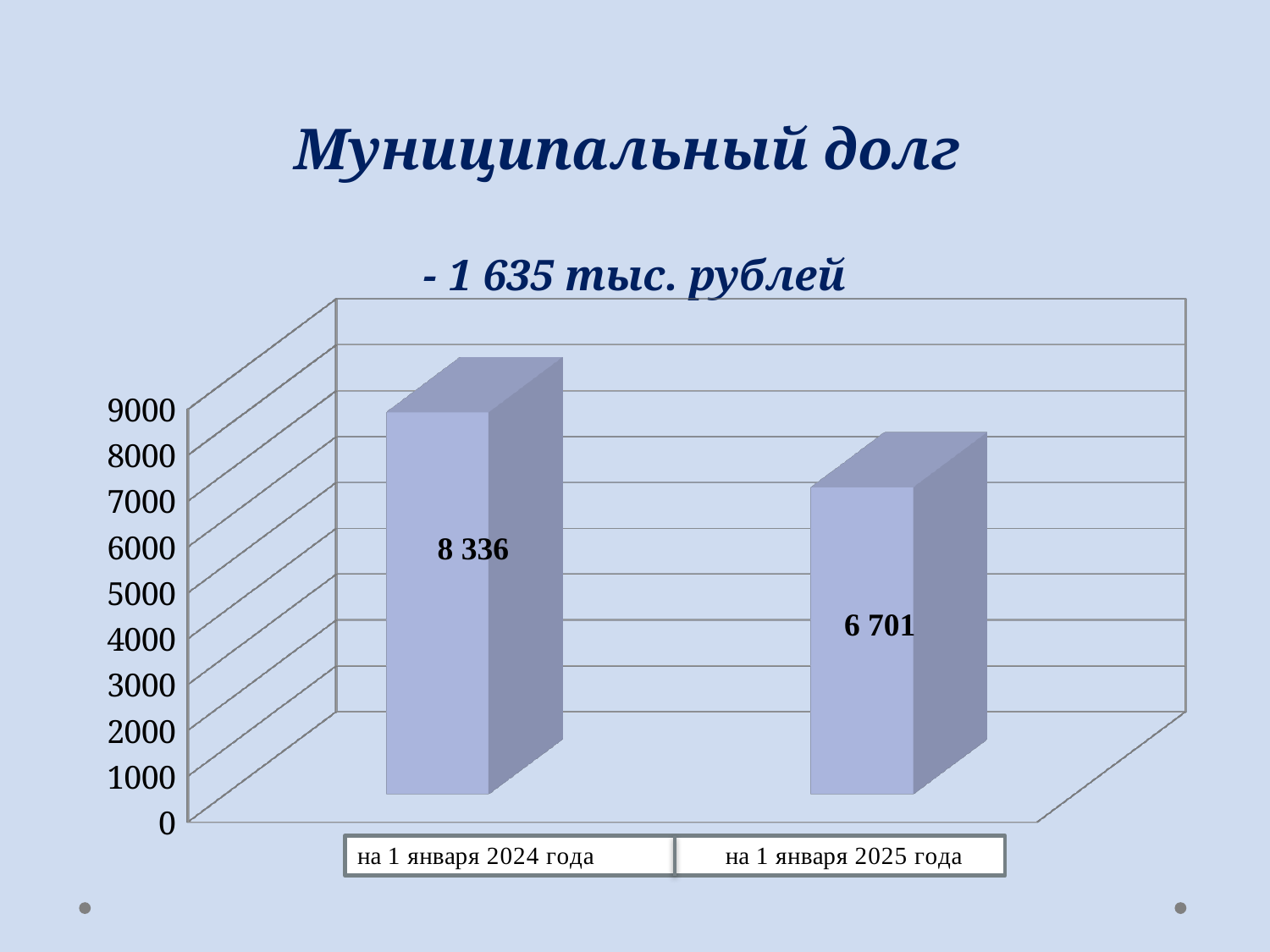
What is the value for 'на 1 января 2024 года'? 8 336 Is the value for 'на 1 января 2024 года' greater or less than 8000? greater What is the value for 'на 1 января 2025 года'? 6 701 What is the title of the slide? Муниципальный долг Which is larger: the value for 'на 1 января 2024 года' or the value for 'на 1 января 2025 года'? на 1 января 2024 года How many categories are shown in the chart? 2 What kind of chart is shown on the slide? bar chart Which category has the highest value? на 1 января 2024 года What is the difference between the value for 'на 1 января 2024 года' and the value for 'на 1 января 2025 года'? 1 635 Which category has the lowest value? на 1 января 2025 года Is the value for 'на 1 января 2025 года' greater or less than 7000? less Do the values rise or fall from 'на 1 января 2024 года' to 'на 1 января 2025 года'? fall